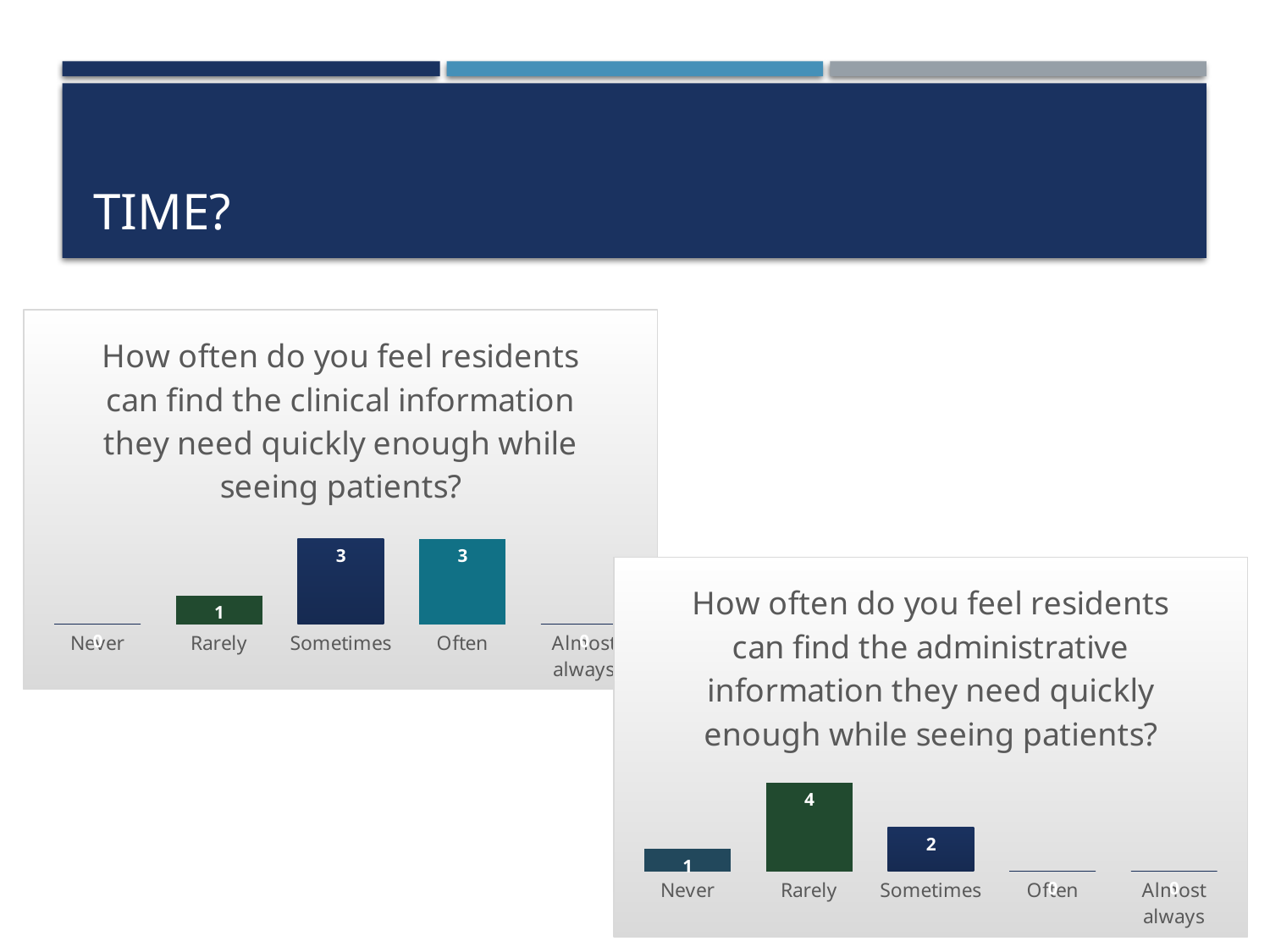
In the chart about administrative information, what is the value for Rarely? 4 In the chart about administrative information, which is larger, the value for Never or the value for Sometimes? Sometimes What kind of chart is the chart about administrative information? Bar chart In the chart about clinical information, what is the difference between the values for Sometimes and Rarely? 2 How many categories are shown on the x axis of the chart about clinical information? 5 In the chart about clinical information, what is the value for Sometimes? 3 In the chart about clinical information, what is the value for Rarely? 1 In the chart about administrative information, which category has the highest value? Rarely In the chart about administrative information, what is the value for Sometimes? 2 In the chart about administrative information, what is the difference between the values for Rarely and Sometimes? 2 In the chart about administrative information, what is the value for Often? 0 In the chart about clinical information, what is the value for Never? 0